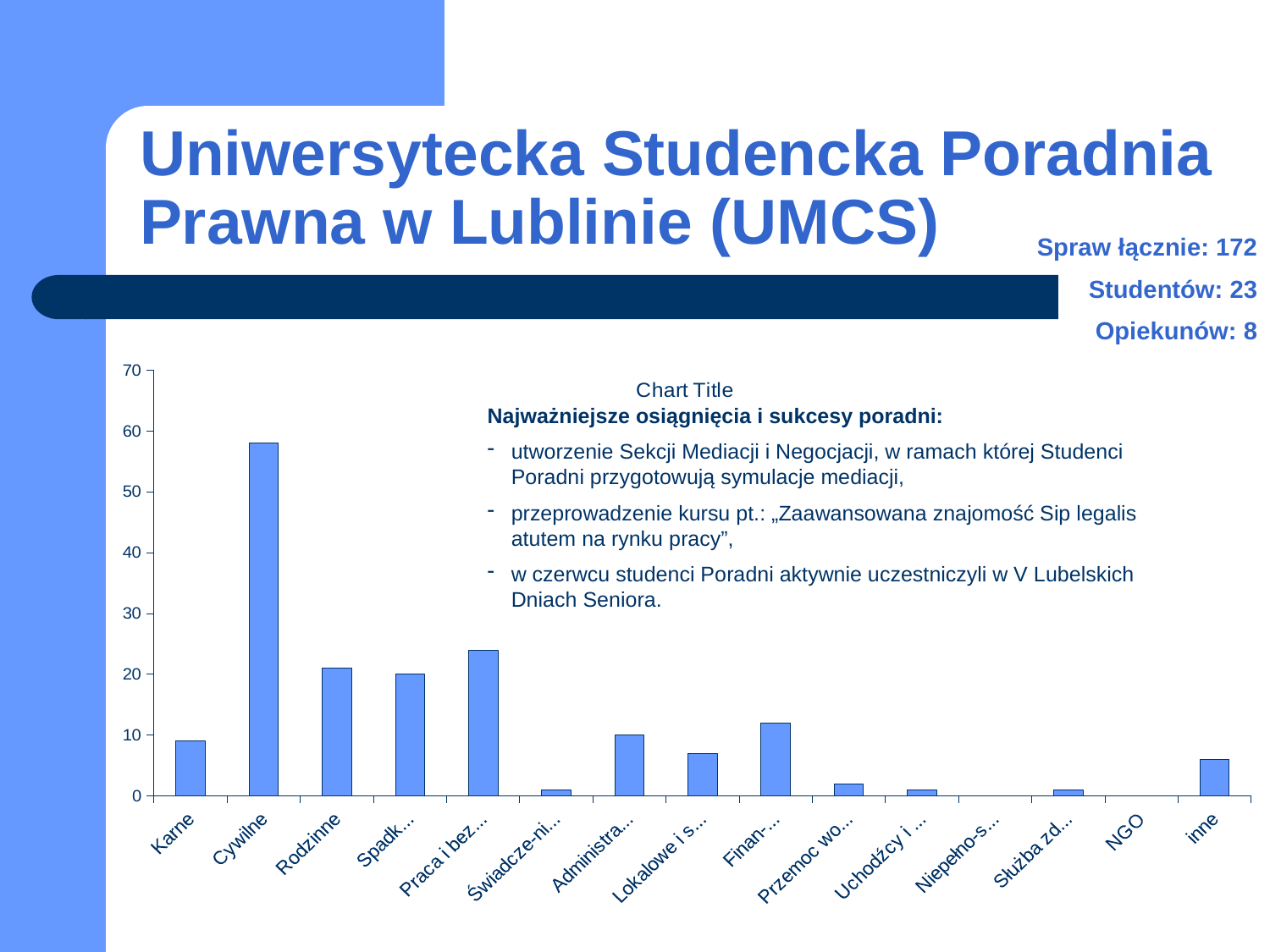
How many categories are shown on the x axis of the chart? 15 Is the value for Finan-... greater or less than 10? greater Is the value for inne greater or less than 10? less Is the value for Cywilne greater or less than 50? greater Which is larger, the value for Cywilne or the value for Rodzinne? Cywilne What is the title shown on the chart? Chart Title Which is larger, the value for Praca i bez... or the value for Karne? Praca i bez... What kind of chart is shown on the slide? bar chart Which category has the highest bar in the chart? Cywilne